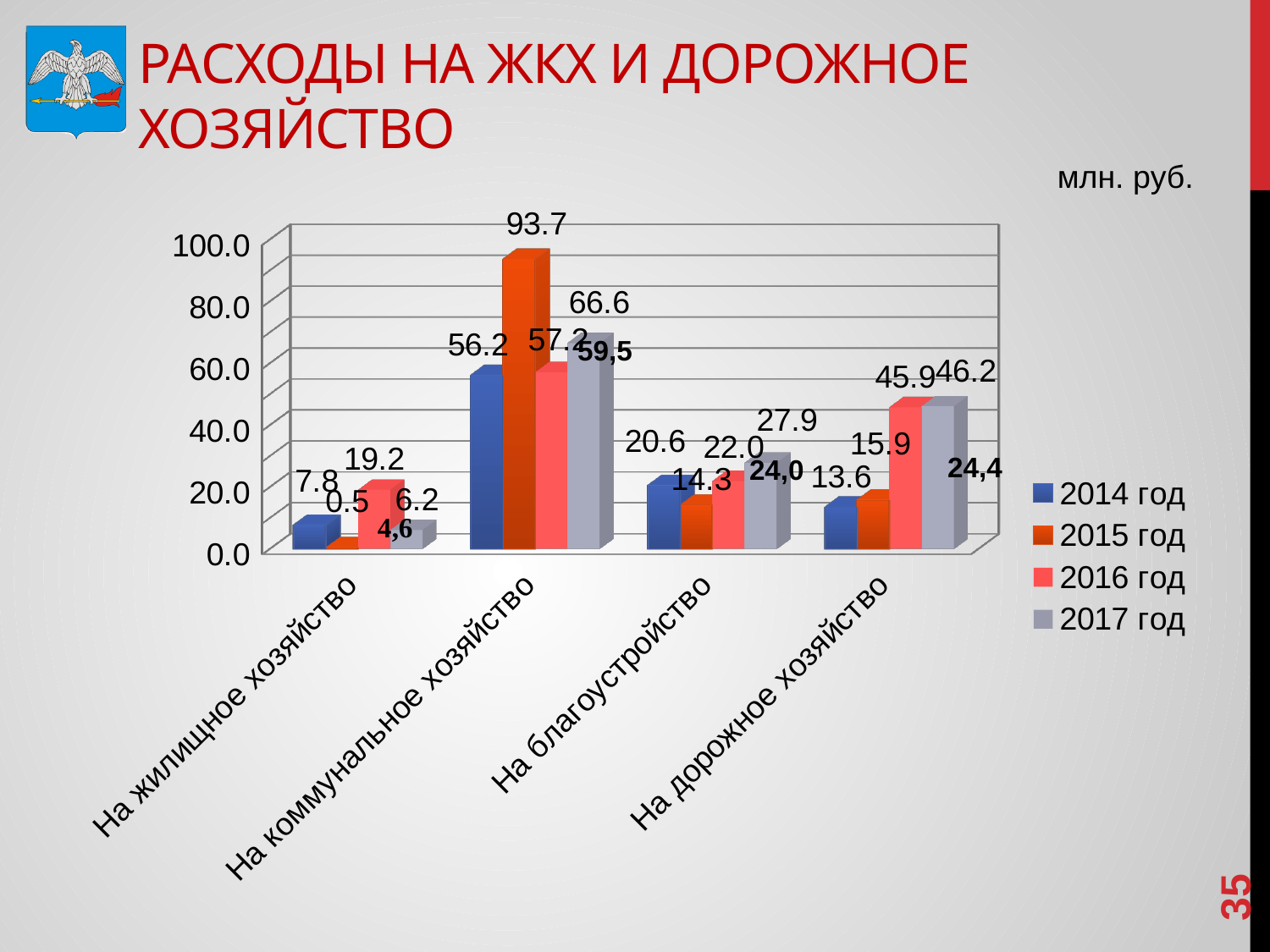
Which category has the highest value for 2015 год? На коммунальное хозяйство What is the value for 2015 год in the category На коммунальное хозяйство? 93.7 What is the difference between the 2015 год and 2014 год values for На коммунальное хозяйство? 37.5 What is the value for 2014 год in the category На жилищное хозяйство? 7.8 Is the value for 2015 год in На коммунальное хозяйство greater or less than 80.0? greater What is the value for 2016 год in the category На дорожное хозяйство? 45.9 What is the value for 2015 год in the category На благоустройство? 14.3 How many series does the legend list? 4 What kind of chart is shown on the slide? bar chart Which category has the lowest value for 2015 год? На жилищное хозяйство How many categories are shown on the x axis? 4 For 2016 год, which is larger: На дорожное хозяйство or На благоустройство? На дорожное хозяйство